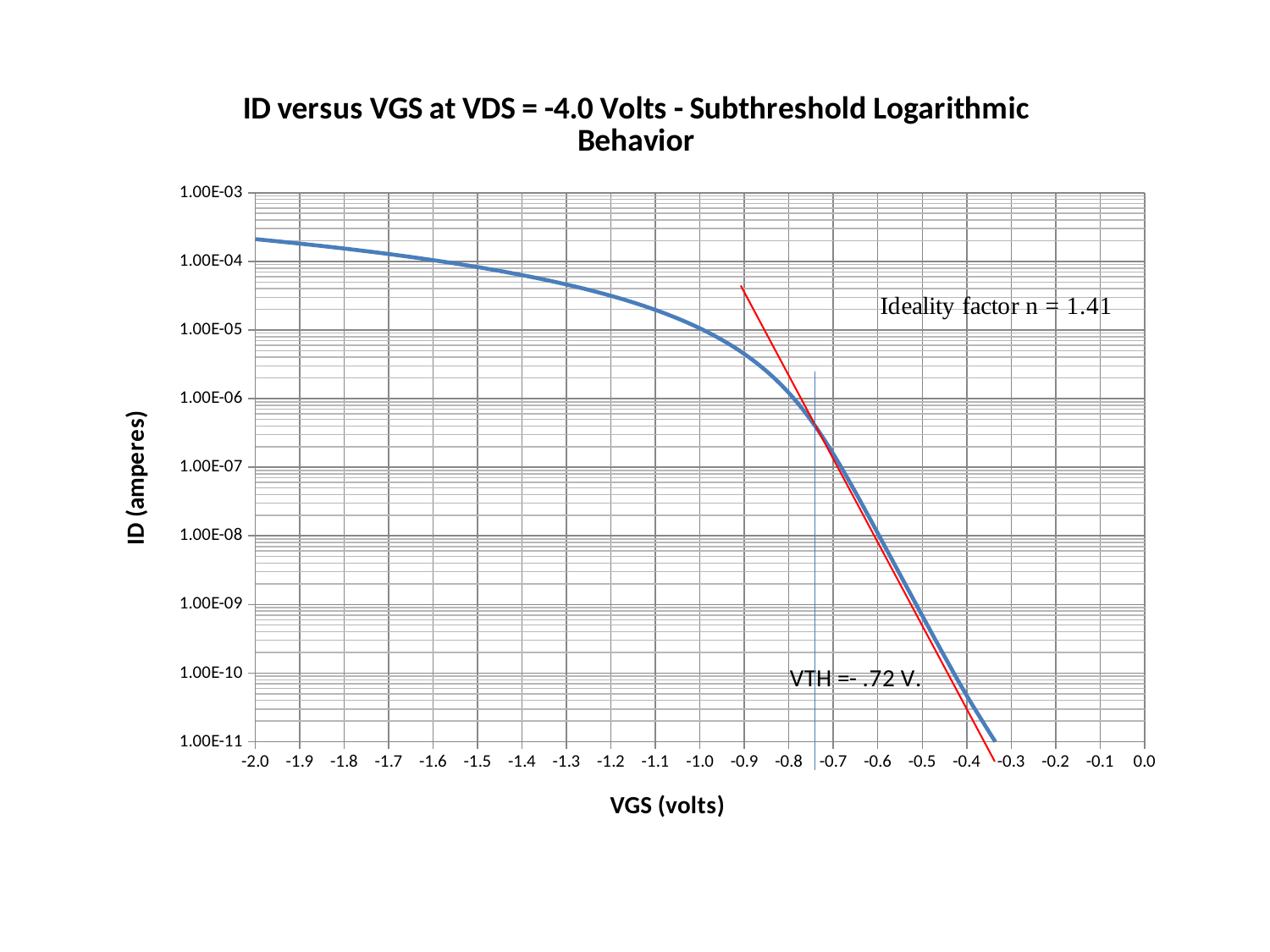
Is ID larger at VGS = -1.5 or at VGS = -0.5? -1.5 Is the value of ID at VGS = -1.2 greater or less than 1.00E-05? greater At which VGS value on the x axis is ID highest? -2.0 Is the value of ID at VGS = -0.4 greater or less than 1.00E-08? less What ideality factor n is annotated on the chart? 1.41 What kind of chart is shown on the slide? line chart What threshold voltage VTH is annotated on the chart? -.72 V Is the value of ID at VGS = -1.5 greater or less than 1.00E-05? greater As VGS increases from -2.0 toward 0.0 along the x axis, does ID rise or fall? fall